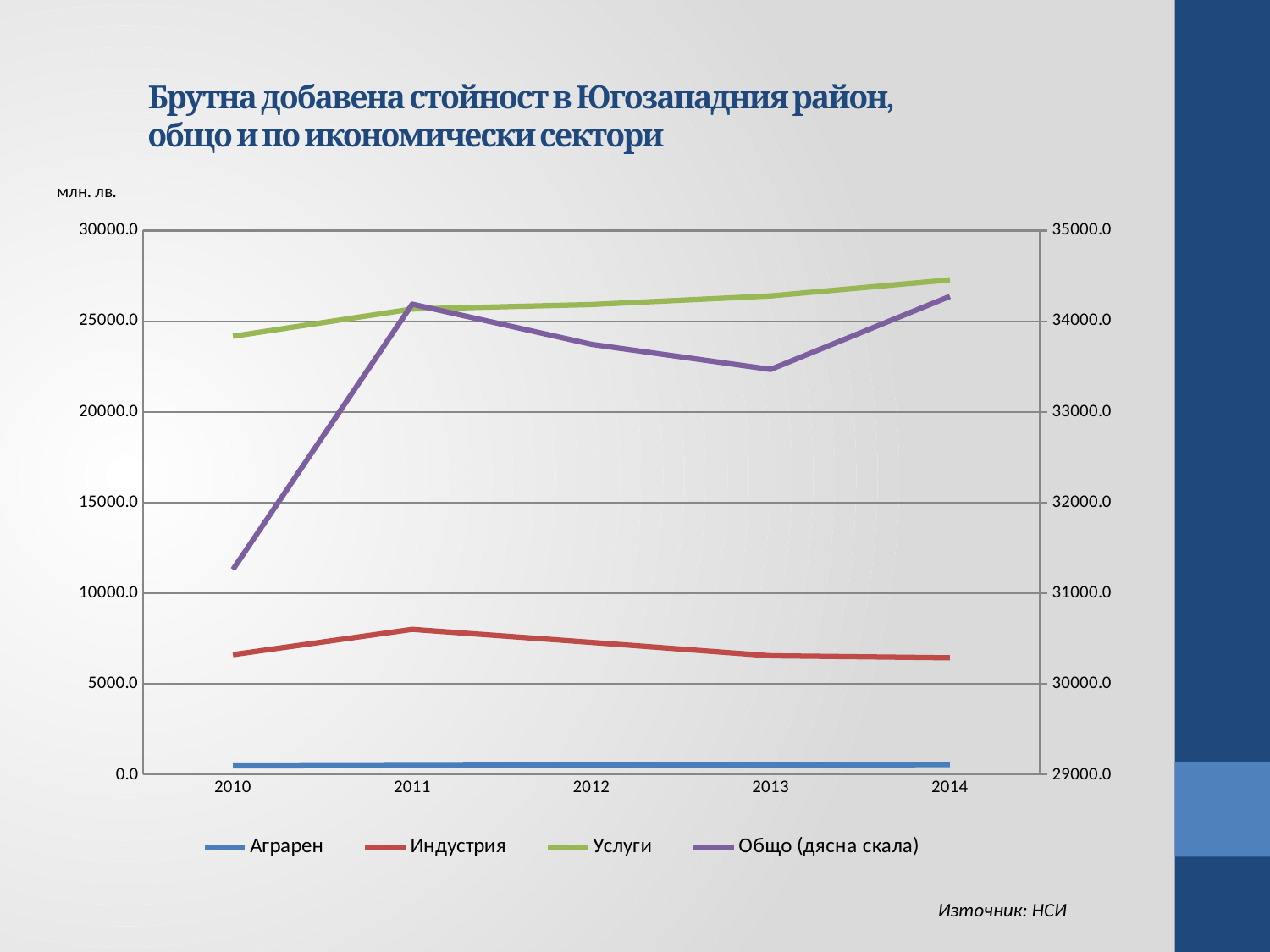
In which year is the Общо (дясна скала) value lowest? 2010 On the right scale, is the Общо (дясна скала) value in 2010 greater or less than 32000.0? less In 2012, which is larger: Услуги or Индустрия? Услуги Is the Услуги value in 2010 greater or less than 20000.0? greater Is the Индустрия value in 2011 greater or less than 10000.0? less Does the Услуги line rise or fall from 2010 to 2014? rise Which series is plotted on the right-hand scale according to the legend? Общо (дясна скала) In which year is the Индустрия value highest? 2011 How many series does the legend list? 4 What kind of chart is shown on the slide? line chart How many years are shown on the x axis? 5 What unit is indicated above the chart? млн. лв.